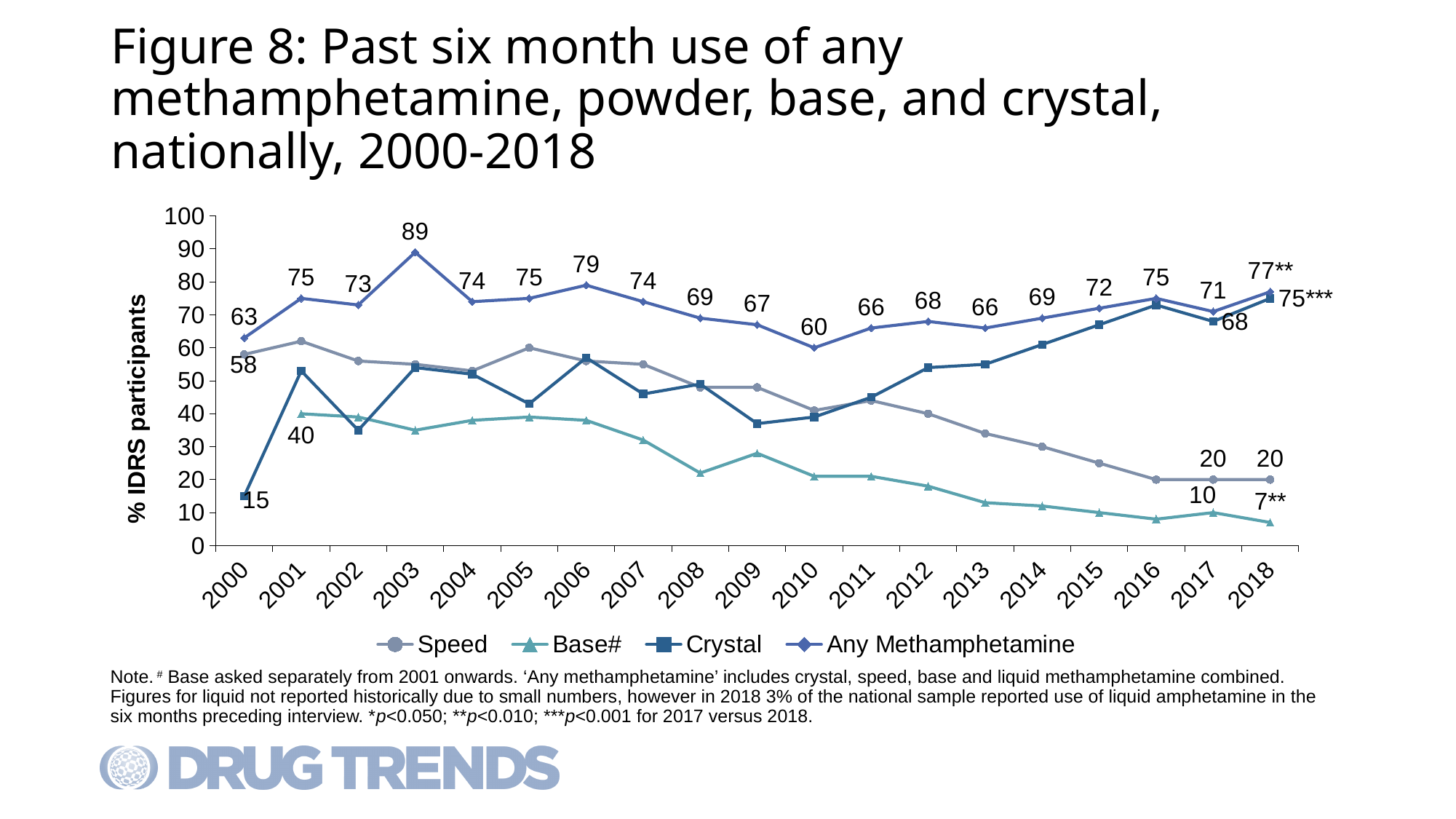
What was the value for Any Methamphetamine in 2003? 89 What kind of chart is shown on the slide? line chart What is the difference between the Any Methamphetamine values in 2003 and 2010? 29 Does the Speed line rise or fall from 2010 to 2018? fall How many series does the legend list? 4 In which year was the value for Any Methamphetamine lowest? 2010 How many years are plotted along the x axis? 19 What was the value for Crystal in 2000? 15 What is the label on the y axis? % IDRS participants In which year was the value for Any Methamphetamine highest? 2003 Is the value for Speed in 2005 greater or less than 50? greater In 2018, which was larger: the value for Speed or the value for Crystal? Crystal